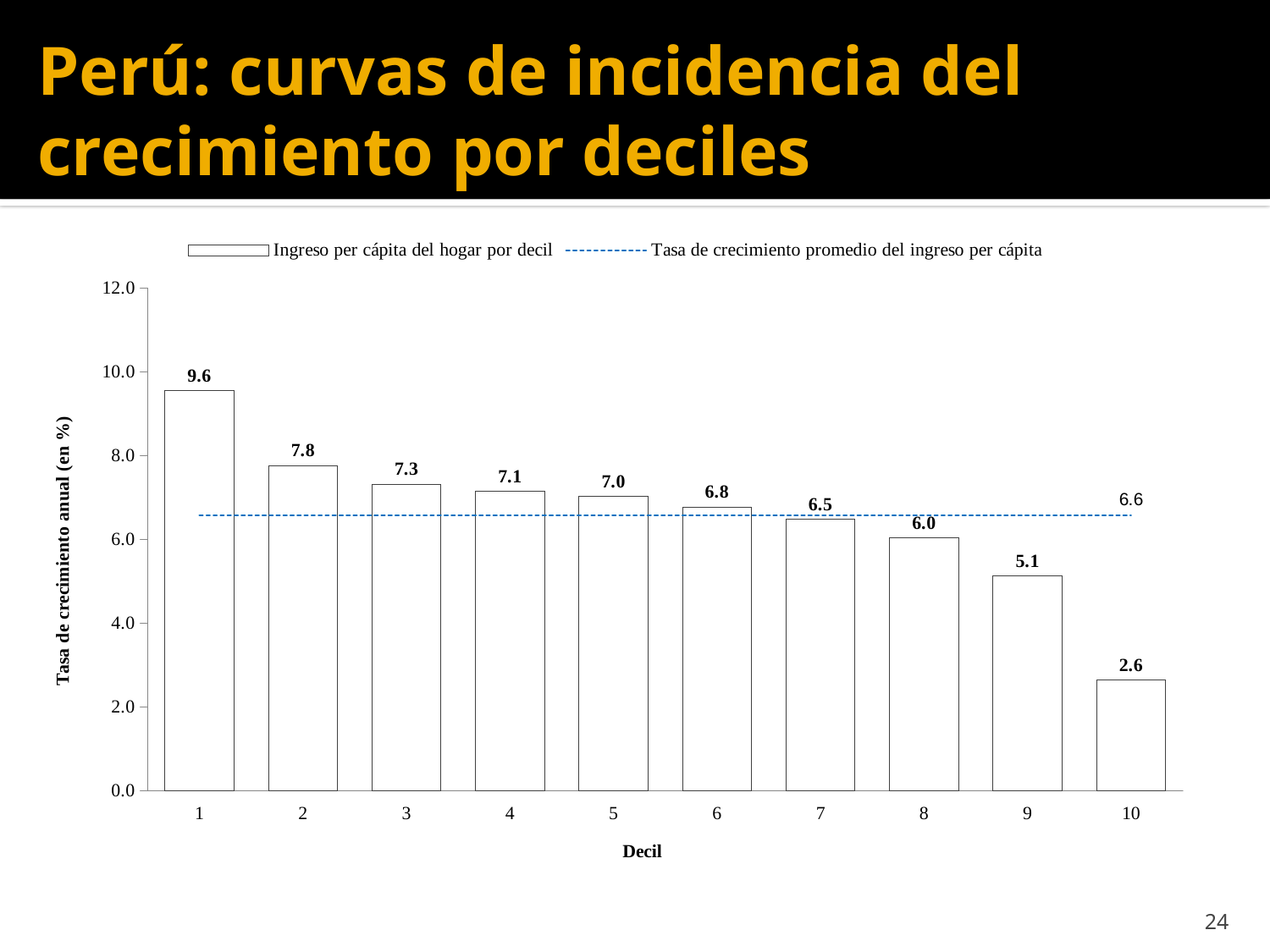
Do the growth rates rise or fall as the decile number increases? Fall How many deciles are shown on the x axis? 10 What is the value of the dashed line for the average growth rate of per capita income? 6.6 What is the annual growth rate for decile 10? 2.6 Which has a higher growth rate, decile 2 or decile 8? Decile 2 What is the annual growth rate for decile 5? 7.0 What kind of chart is shown on the slide? Combination bar and line chart Which decile has the lowest annual growth rate? 10 What is the difference between the growth rate of decile 1 and decile 10? 7.0 Which decile has the highest annual growth rate? 1 How many series does the legend list? 2 What is the annual growth rate for decile 1? 9.6